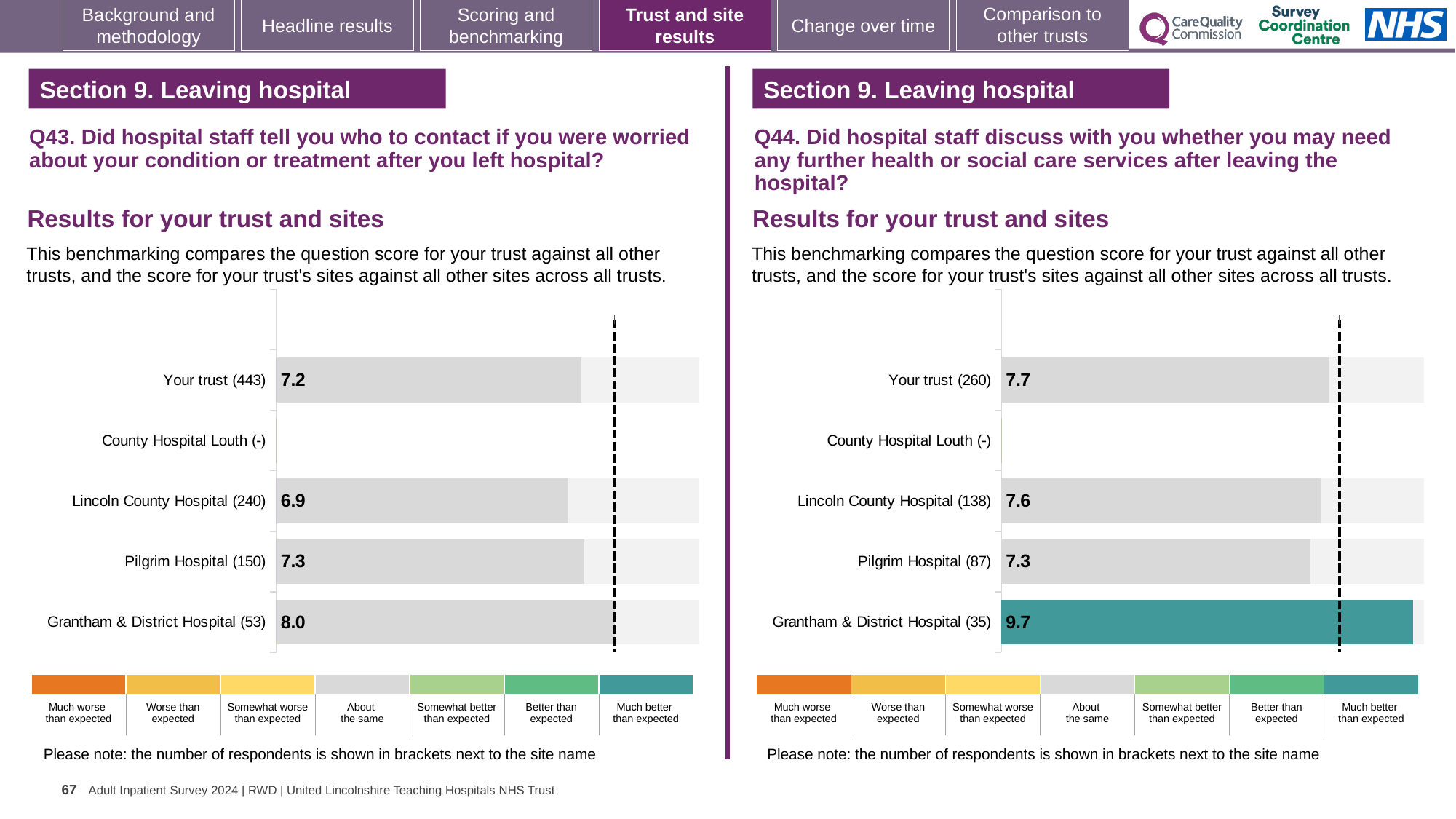
In the Q44 chart on the right, which benchmark category does the colour of the Grantham & District Hospital (35) bar correspond to? Much better than expected In the Q43 chart on the left, what is the score for Your trust (443)? 7.2 In the Q44 chart on the right, which is larger, the score for Your trust (260) or Lincoln County Hospital (138)? Your trust (260) In the Q43 chart on the left, what is the difference between the scores for Grantham & District Hospital (53) and Pilgrim Hospital (150)? 0.7 In the Q43 chart on the left, what is the score for Lincoln County Hospital (240)? 6.9 In the Q44 chart on the right, what is the score for Pilgrim Hospital (87)? 7.3 In the Q43 chart on the left, which site has the highest score? Grantham & District Hospital (53) In the Q44 chart on the right, what is the score for Grantham & District Hospital (35)? 9.7 How many site/trust categories are listed on the Q44 chart on the right? 5 In the Q44 chart on the right, what is the difference between the scores for Grantham & District Hospital (35) and Your trust (260)? 2.0 In the Q43 chart on the left, which site with a plotted score has the lowest score? Lincoln County Hospital (240) What kind of chart is used for the Q43 results on the left? Bar chart